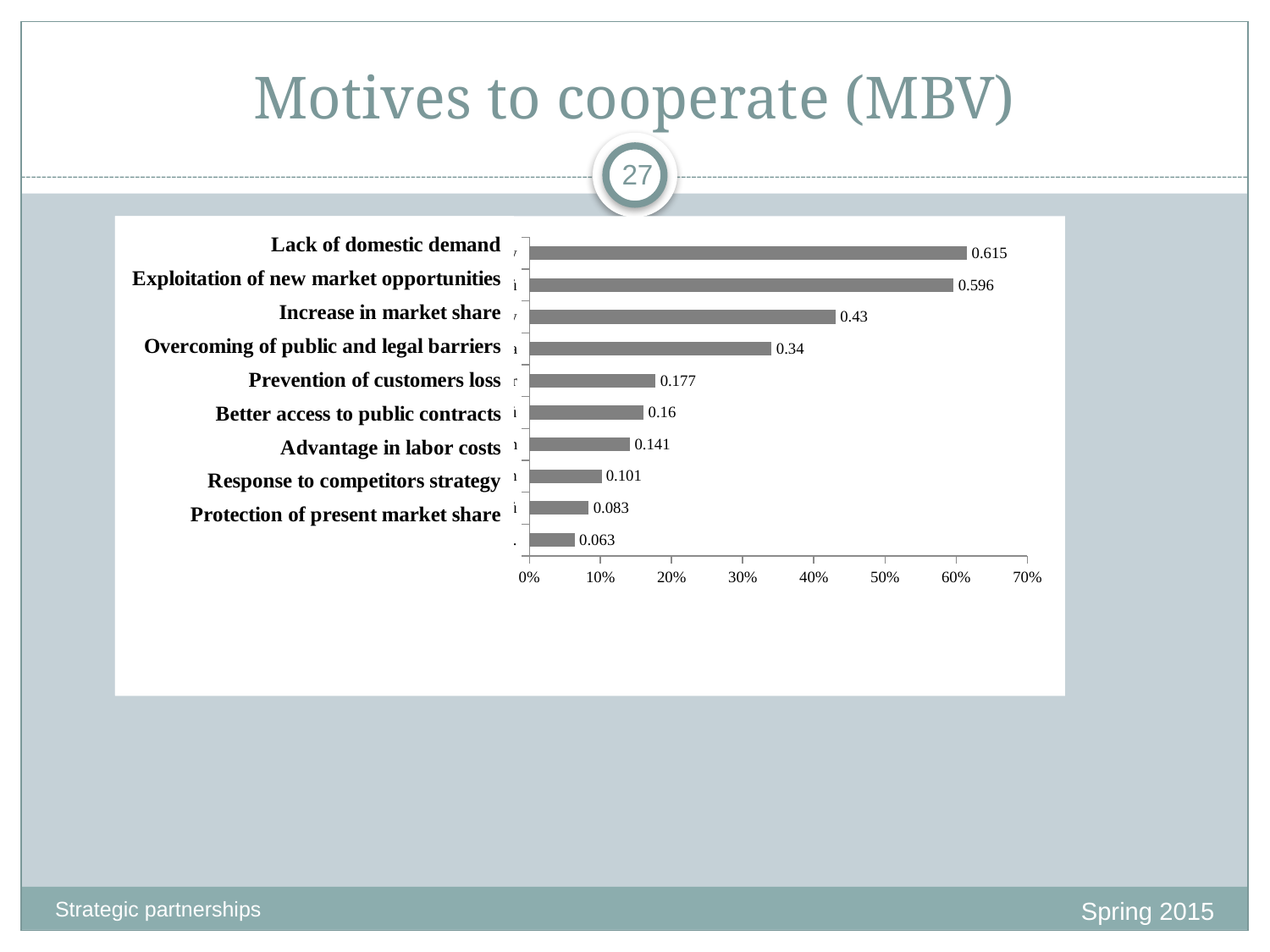
Is the value for Increase in market share greater or less than 40%? greater What is the smallest value labelled on the chart? 0.063 What is the value shown for Overcoming of public and legal barriers? 0.34 What is the value shown for Lack of domestic demand? 0.615 Which is larger, the value for Prevention of customers loss or the value for Better access to public contracts? Prevention of customers loss How many bars are plotted on the chart? 10 What kind of chart is shown on the slide? Bar chart What is the value shown for Advantage in labor costs? 0.141 Which motive has the highest value? Lack of domestic demand What is the difference between the values for Increase in market share and Overcoming of public and legal barriers? 0.09 What is the value shown for Protection of present market share? 0.083 What is the difference between the values for Lack of domestic demand and Exploitation of new market opportunities? 0.019